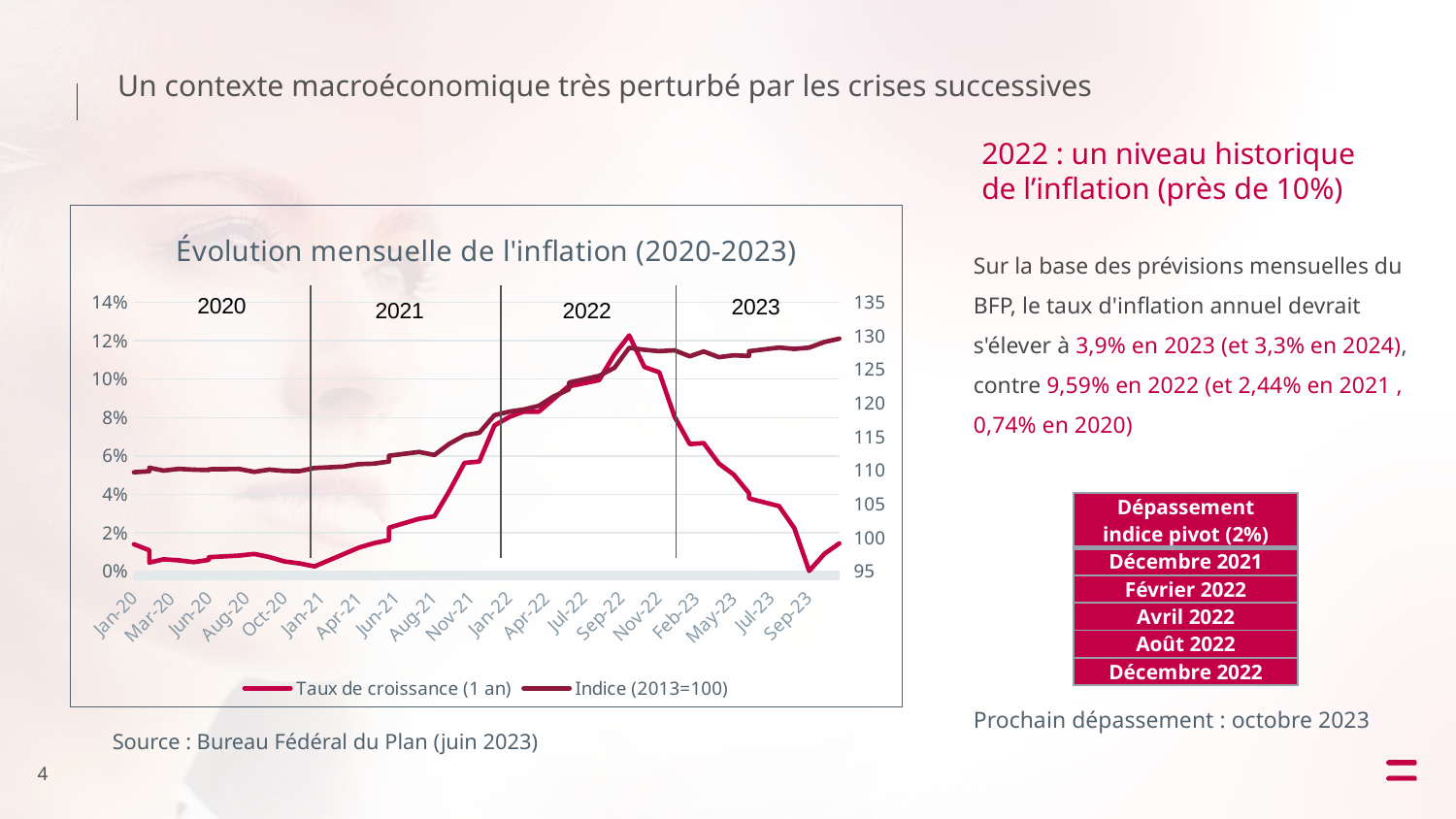
What is the title of the chart? Évolution mensuelle de l'inflation (2020-2023) Is the peak value of Taux de croissance (1 an) in 2022 greater or less than 10%? greater Is the value of Indice (2013=100) in Sep-23 greater or less than 125? greater What kind of chart is shown on the slide? line chart Is the value of Taux de croissance (1 an) in Jan-20 greater or less than 2%? less How many series does the chart's legend list? 2 Which is larger, Indice (2013=100) in Jan-20 or in Feb-23? Feb-23 Which is larger, Taux de croissance (1 an) in Jan-21 or in Jan-22? Jan-22 What are the two series named in the chart's legend? Taux de croissance (1 an) and Indice (2013=100) Does Indice (2013=100) generally rise or fall from Jan-20 to Sep-23? rise In which year does Taux de croissance (1 an) reach its highest value? 2022